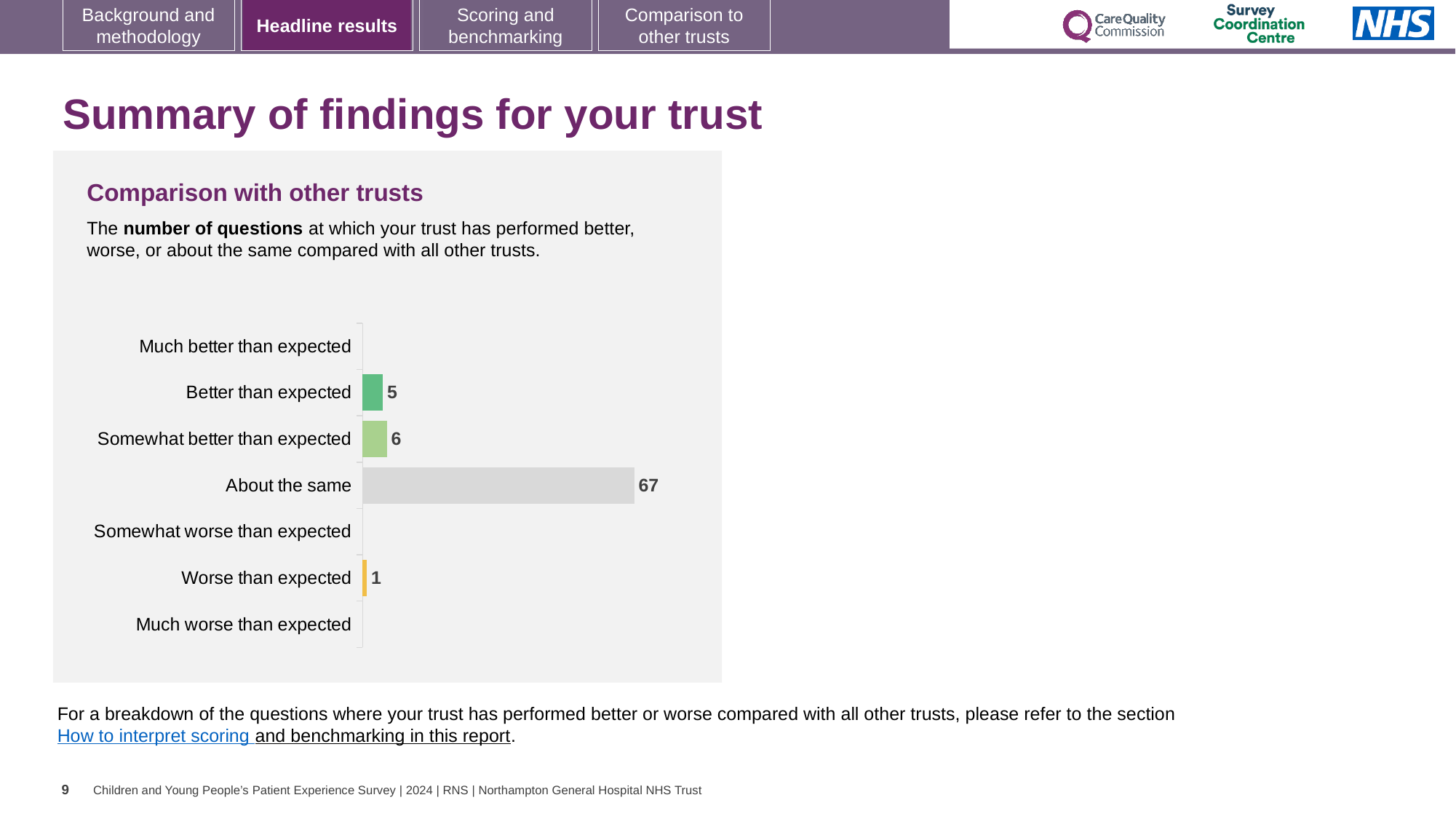
What is the total of the 'Better than expected' and 'Somewhat better than expected' values? 11 How many categories are listed on the chart's axis? 7 Which is larger, the value for 'Better than expected' or the value for 'Worse than expected'? Better than expected What is the value for 'Somewhat better than expected'? 6 What is the value for 'Better than expected'? 5 How many questions are in the 'About the same' category? 67 What is the title of the chart section on the slide? Comparison with other trusts What kind of chart is shown on the slide? Bar chart What is the difference between 'Somewhat better than expected' and 'Better than expected'? 1 What is the difference between the 'About the same' value and the 'Somewhat better than expected' value? 61 Which category has the highest number of questions? About the same What is the value for 'Worse than expected'? 1